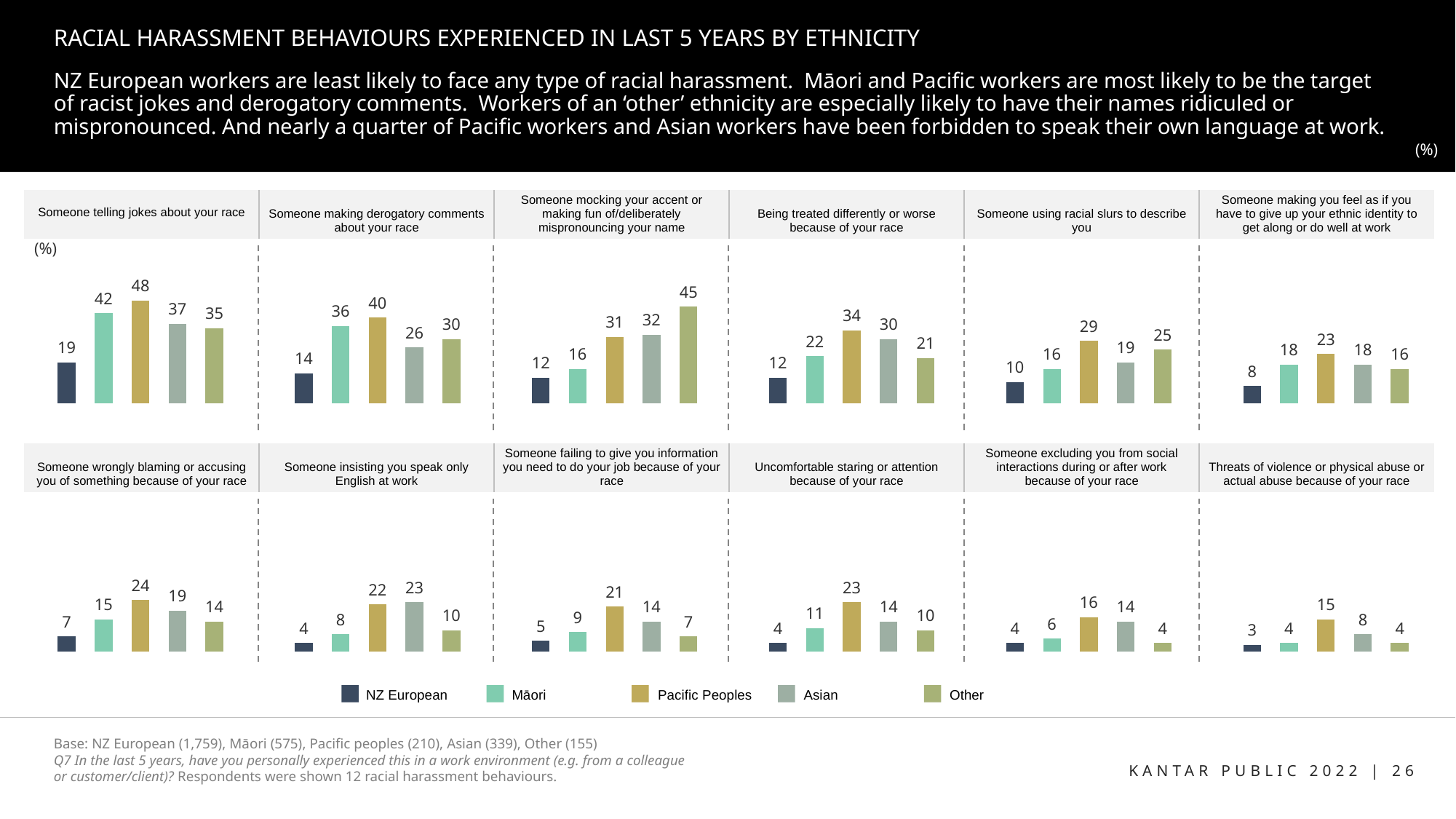
In the chart 'Someone insisting you speak only English at work', what is the value for Asian? 23 In the chart 'Being treated differently or worse because of your race', what is the difference between the Pacific Peoples value and the NZ European value? 22 In the chart 'Threats of violence or physical abuse or actual abuse because of your race', which ethnicity has the lowest value? NZ European Which legend entry is shown in dark navy blue? NZ European In the chart 'Someone mocking your accent or making fun of/deliberately mispronouncing your name', which ethnicity has the highest value? Other In the chart 'Someone making derogatory comments about your race', what is the value for Māori? 36 In the chart 'Someone wrongly blaming or accusing you of something because of your race', what is the difference between the Pacific Peoples value and the Other value? 10 How many series does the legend list? 5 In the chart 'Someone excluding you from social interactions during or after work because of your race', what is the value for Pacific Peoples? 16 In the chart 'Someone telling jokes about your race', what is the value for Pacific Peoples? 48 In the chart 'Someone using racial slurs to describe you', which is larger: the value for Asian or the value for Other? Other What kind of chart is used for 'Uncomfortable staring or attention because of your race'? Bar chart